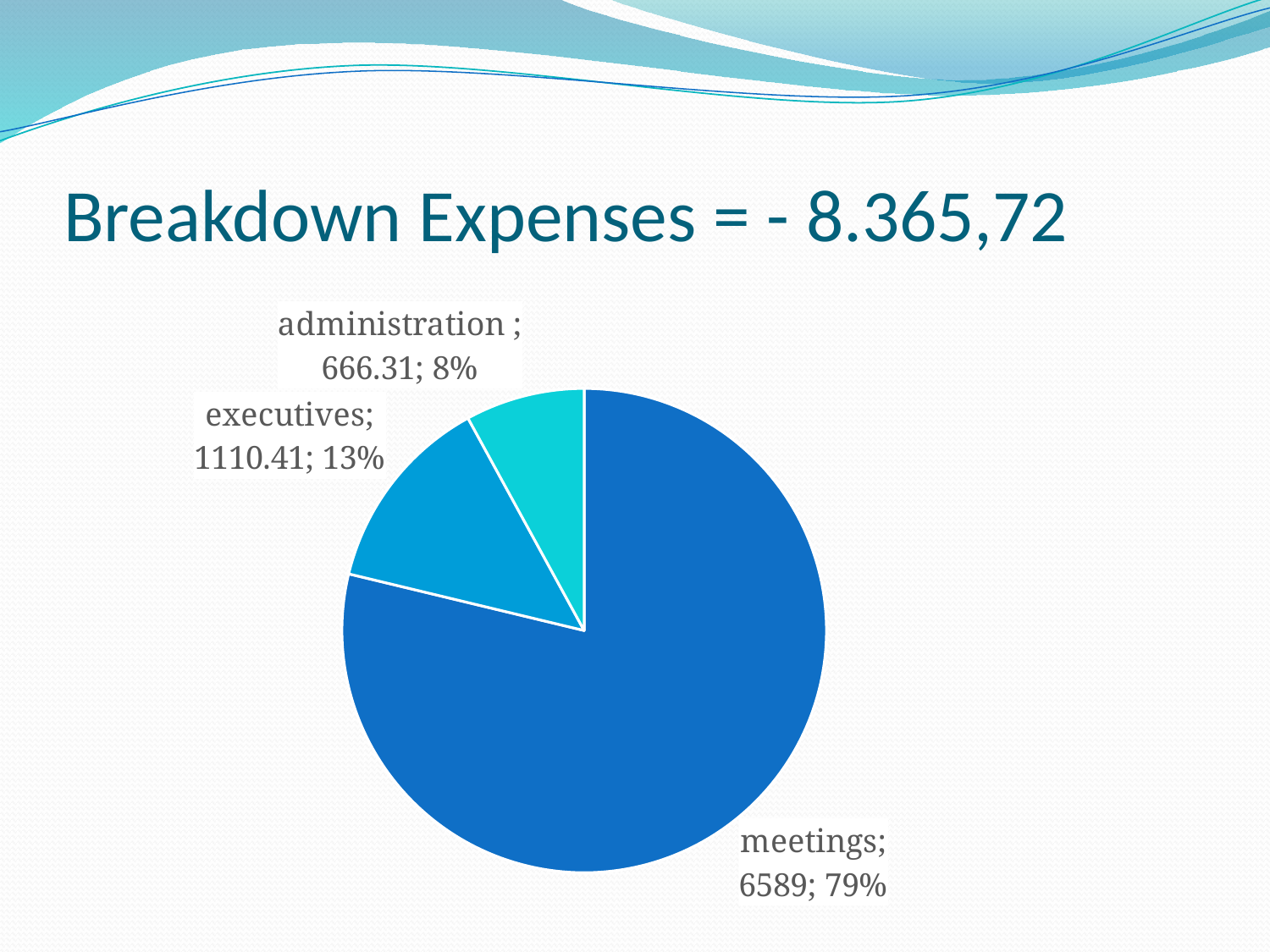
What share of the pie does executives represent? 13% What type of chart is shown on the slide? pie chart Which is larger, executives or administration? executives What is the value for administration? 666.31 How many slices does the pie chart have? 3 Which category has the smallest slice? administration Which category has the largest slice? meetings What share of the pie does meetings represent? 79% What is the value for executives? 1110.41 What is the value for meetings? 6589 What is the difference between the values for executives and administration? 444.1 What share of the pie does administration represent? 8%